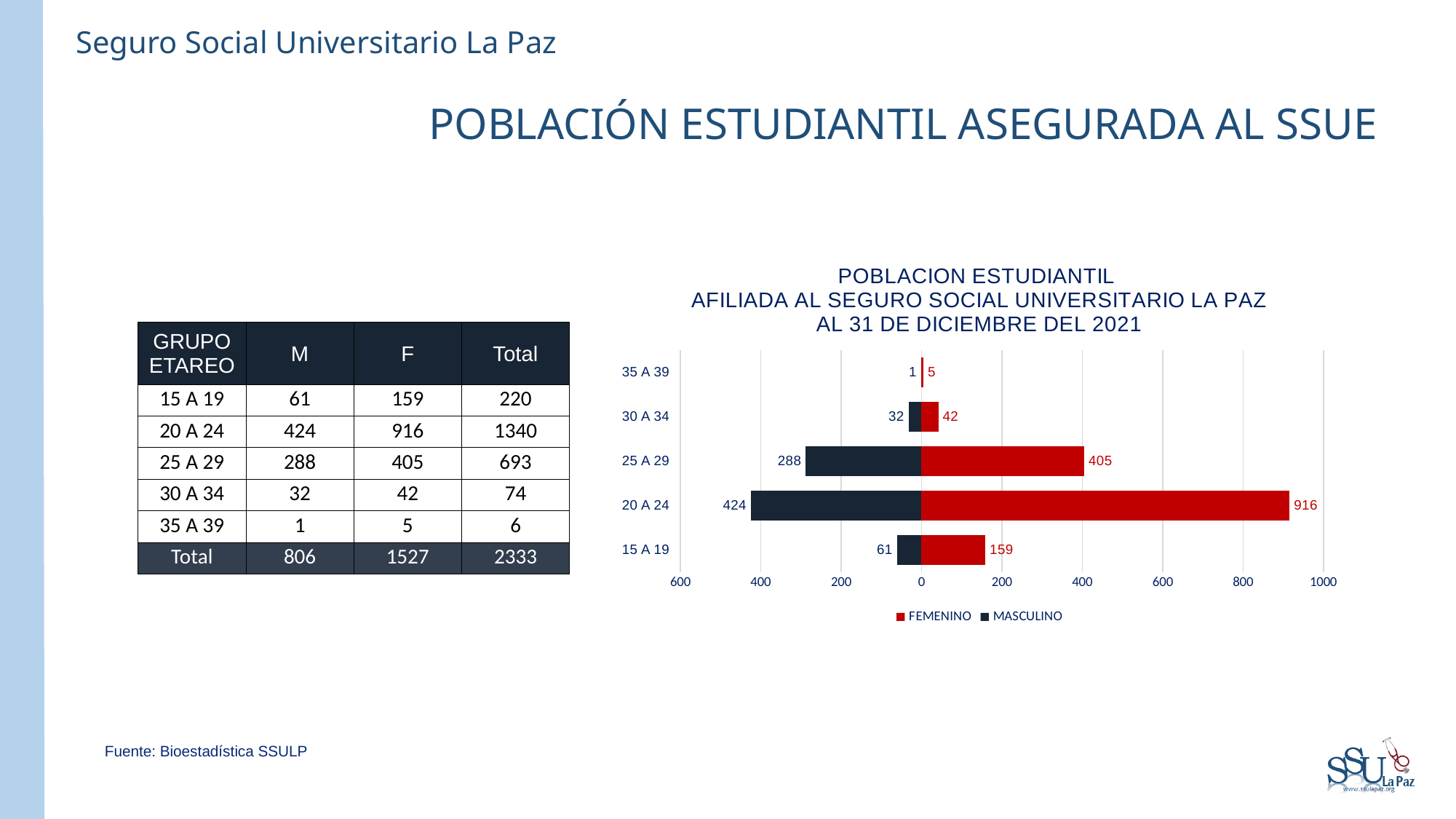
What type of chart is shown on the slide? bar chart What is the MASCULINO value for the 25 A 29 age group? 288 What is the FEMENINO value for the 15 A 19 age group? 159 What is the difference between the FEMENINO and MASCULINO values for the 25 A 29 age group? 117 Which age group has the highest FEMENINO value? 20 A 24 Which age group has the lowest MASCULINO value? 35 A 39 Which colour represents the FEMENINO series? red How many age groups are shown on the chart? 5 What is the total of FEMENINO and MASCULINO for the 20 A 24 age group? 1340 Which is larger for the 30 A 34 age group, the FEMENINO value or the MASCULINO value? FEMENINO What is the FEMENINO value for the 20 A 24 age group? 916 How many series does the legend list? 2